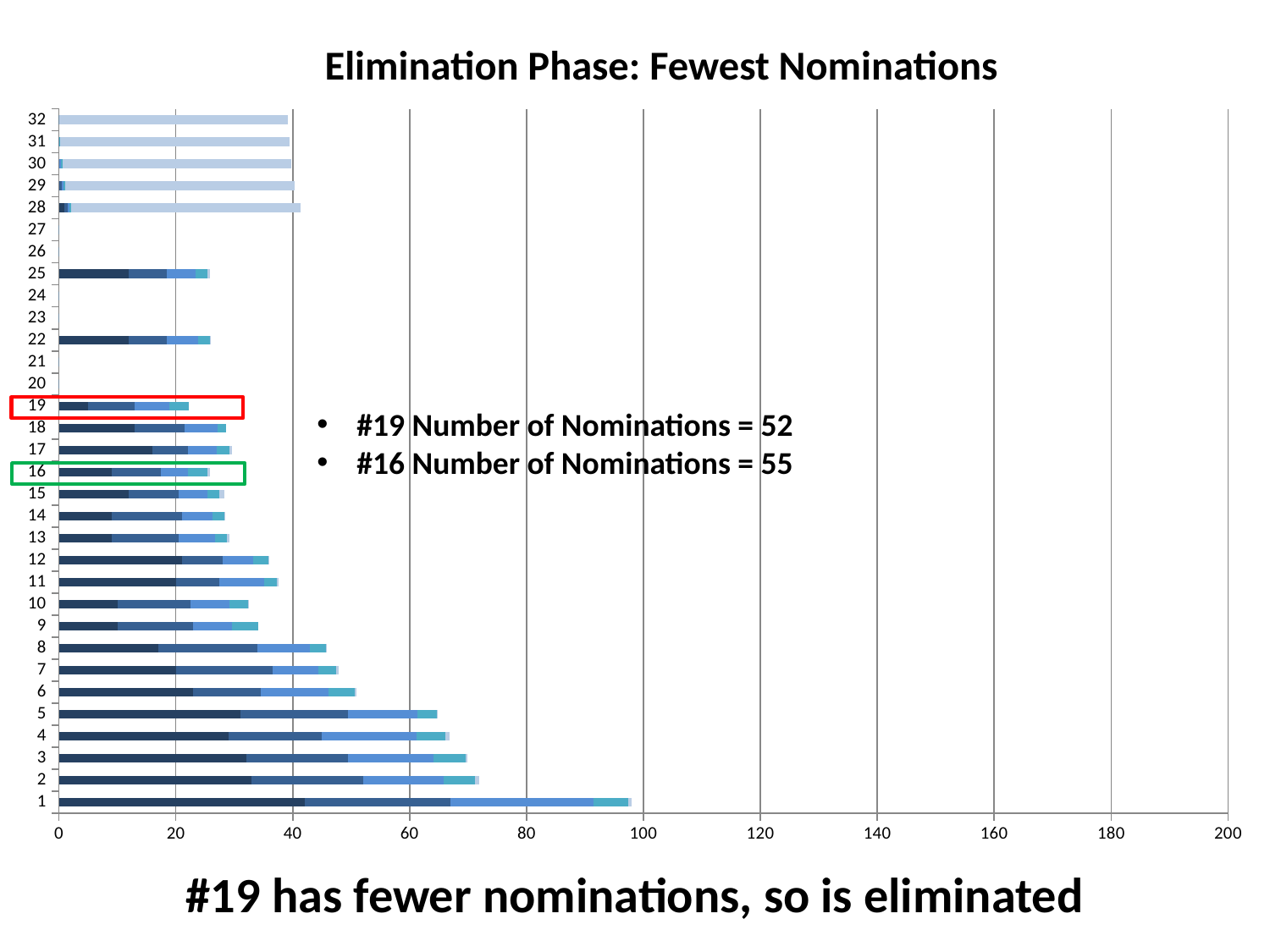
Is the value for category 5 greater or less than 60? greater Which category has the longest bar in the chart? 1 Is the value for category 1 greater or less than 80? greater How many categories are listed on the vertical axis of the chart? 32 Is the value for category 1 greater or less than 100? less Which has the longer bar, category 1 or category 2? 1 What is the title of the chart? Elimination Phase: Fewest Nominations What kind of chart is shown on the slide? Bar chart How many categories on the vertical axis have no bar at all? 6 Which has the longer bar, category 19 or category 18? 18